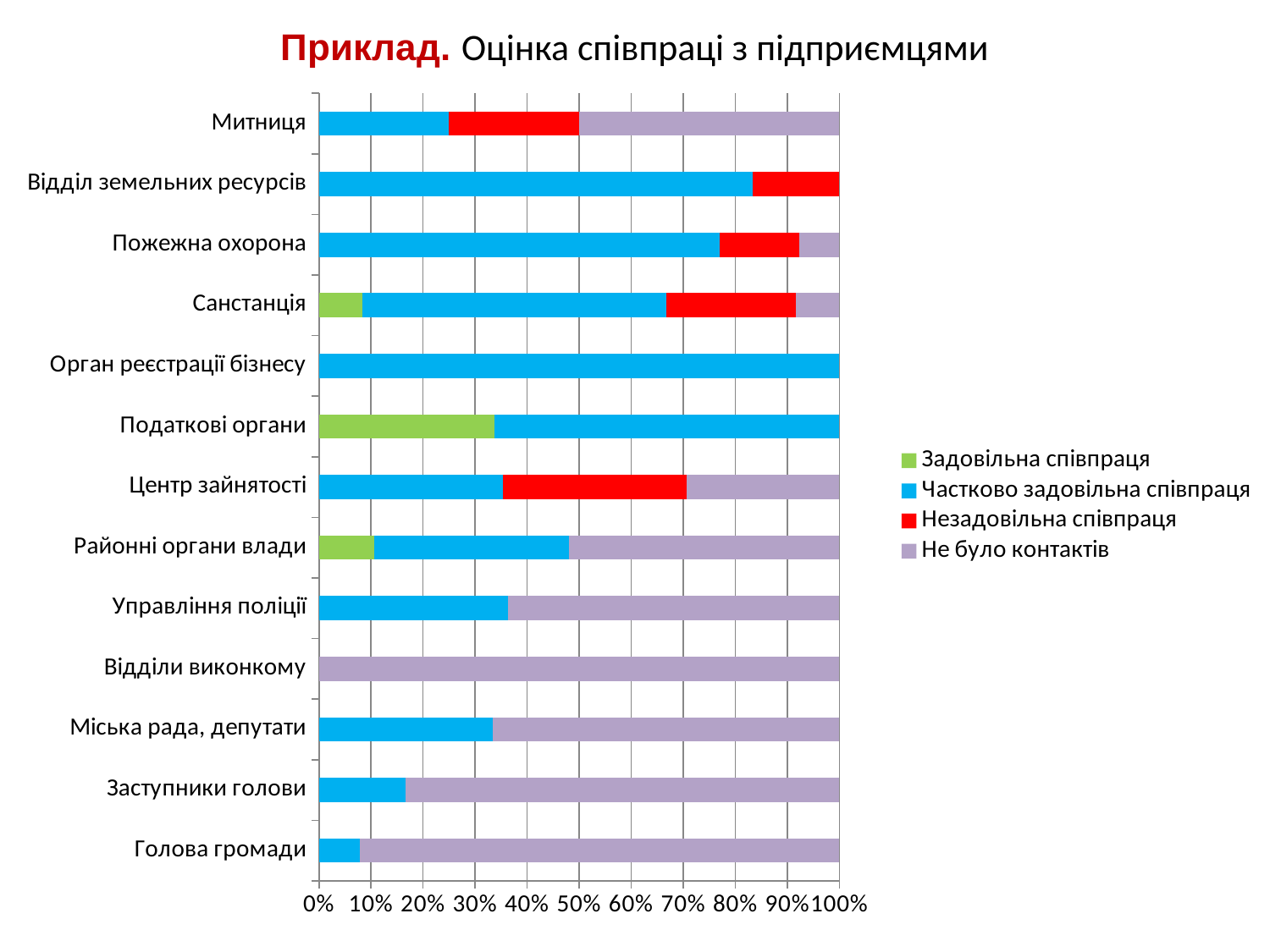
How many categories (institutions) are listed on the vertical axis of the chart? 13 How many series does the chart legend list? 4 Is the 'Частково задовільна співпраця' value for Голова громади greater or less than 10%? less Which category has its entire bar filled with 'Не було контактів'? Відділи виконкому Which has a larger 'Незадовільна співпраця' segment: Центр зайнятості or Пожежна охорона? Центр зайнятості Which category has the largest 'Задовільна співпраця' segment? Податкові органи Is the 'Частково задовільна співпраця' value for Митниця greater or less than 30%? less Which category has its entire bar filled with 'Частково задовільна співпраця'? Орган реєстрації бізнесу What kind of chart is shown on the slide? Stacked bar chart What colour represents 'Незадовільна співпраця' in the chart? Red Which has a larger 'Не було контактів' segment: Голова громади or Санстанція? Голова громади Is the 'Частково задовільна співпраця' value for Відділ земельних ресурсів greater or less than 80%? greater